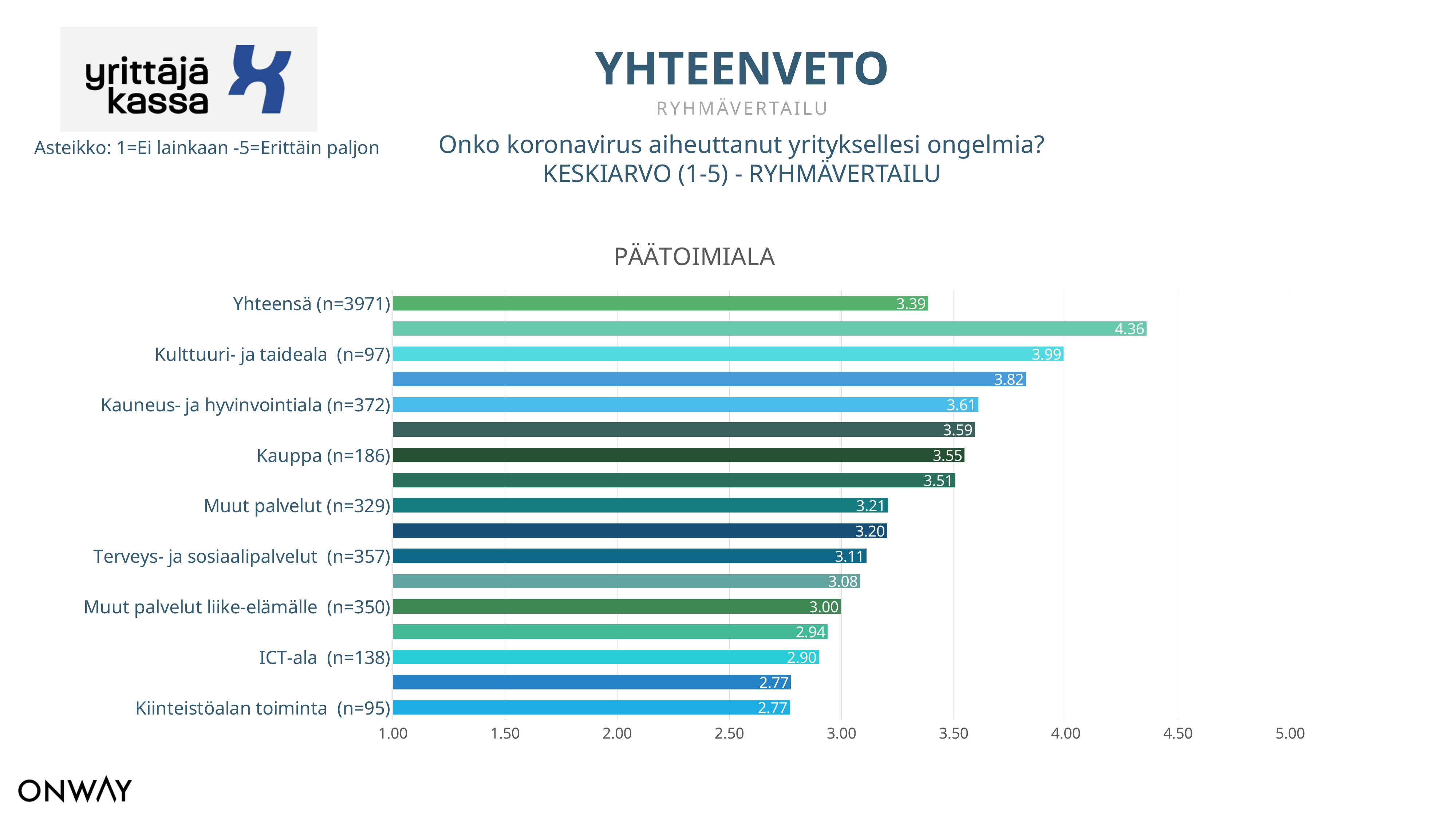
How many bars are plotted in the chart? 17 Which has a larger value, Muut palvelut (n=329) or Terveys- ja sosiaalipalvelut (n=357)? Muut palvelut (n=329) What is the value for Kiinteistöalan toiminta (n=95)? 2.77 What is the value for Kauneus- ja hyvinvointiala (n=372)? 3.61 What is the value for Kulttuuri- ja taideala (n=97)? 3.99 What is the value for Yhteensä (n=3971)? 3.39 What kind of chart is shown on the slide? bar chart What is the difference between the values for Kulttuuri- ja taideala (n=97) and Yhteensä (n=3971)? 0.60 What is the value for Kauppa (n=186)? 3.55 What is the title of the chart? PÄÄTOIMIALA What is the value for ICT-ala (n=138)? 2.90 Is the value for Muut palvelut liike-elämälle (n=350) greater or less than 3.50? less